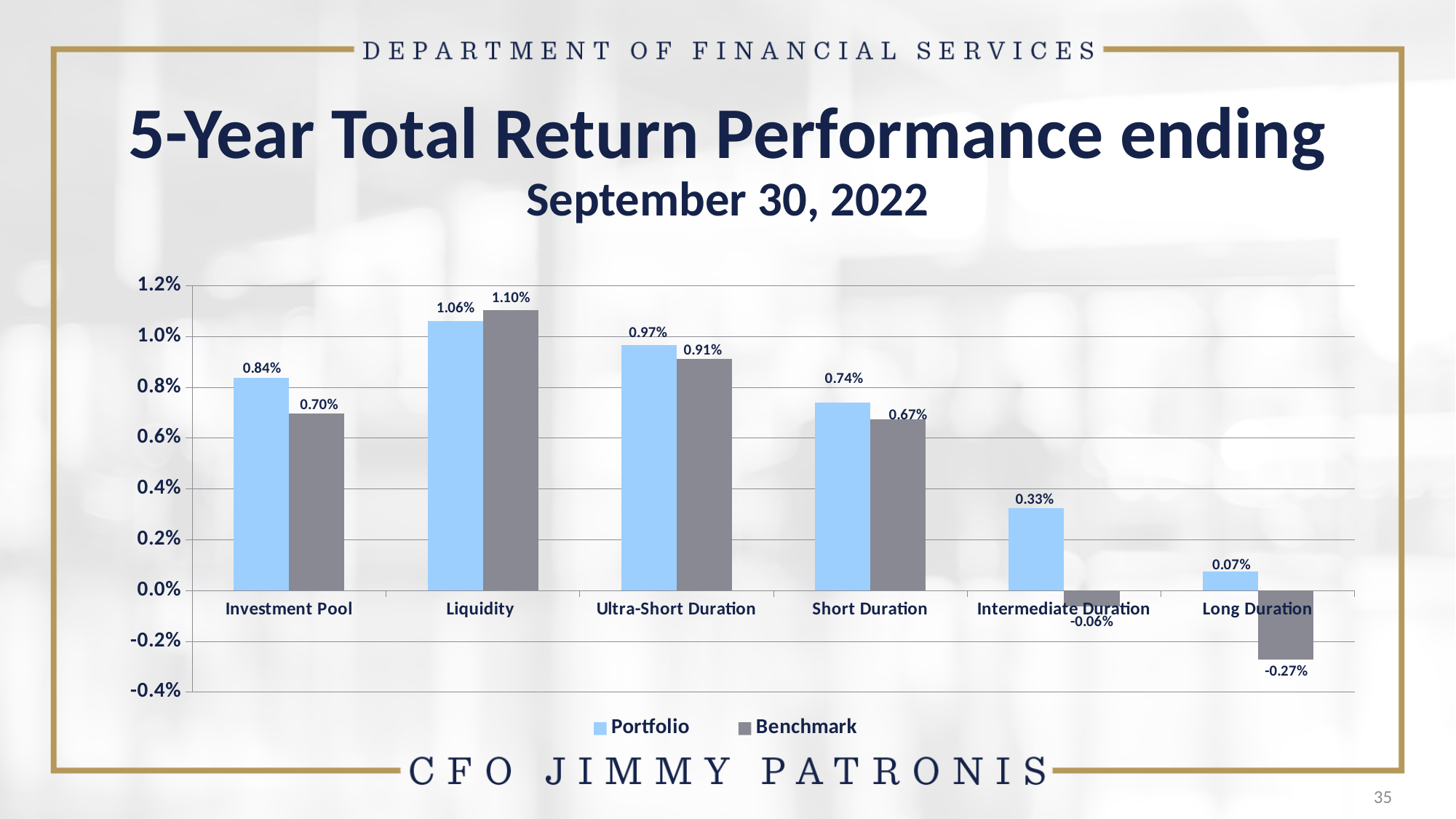
What is the Benchmark value for Long Duration? -0.27% What is the Portfolio value for Investment Pool? 0.84% What is the Portfolio value for Intermediate Duration? 0.33% What is the difference between the Portfolio and Benchmark values for Investment Pool? 0.14% Which category has the lowest Benchmark value? Long Duration What kind of chart is shown on the slide? Bar chart What is the Benchmark value for Liquidity? 1.10% Which category has the highest Portfolio value? Liquidity Which series is shown in light blue? Portfolio How many categories are shown on the x axis? 6 How many series does the legend list? 2 For Ultra-Short Duration, which is larger, the Portfolio or the Benchmark value? Portfolio